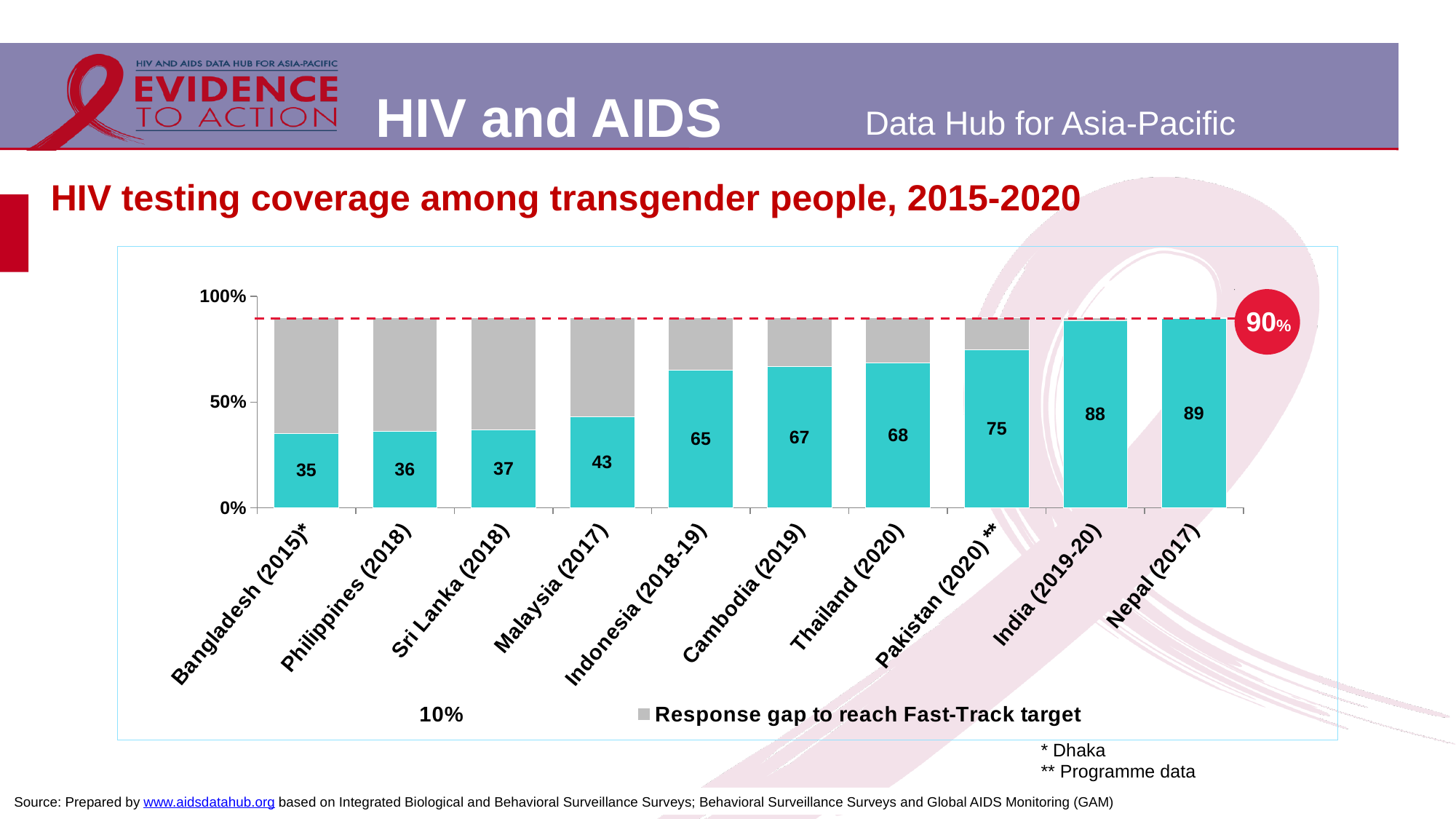
What kind of chart is used on this slide? Stacked bar chart Which country has the lowest HIV testing coverage value on the chart? Bangladesh (2015)* Do the HIV testing coverage values rise or fall from left to right across the chart? Rise What is the difference between the HIV testing coverage values for Pakistan (2020)** and Indonesia (2018-19)? 10 Is the HIV testing coverage value for Philippines (2018) greater or less than 50%? less How many countries are shown on the chart? 10 Which has a higher HIV testing coverage value, Cambodia (2019) or Sri Lanka (2018)? Cambodia (2019) What is the HIV testing coverage value shown for Thailand (2020)? 68 What is the HIV testing coverage value shown for India (2019-20)? 88 What is the HIV testing coverage value shown for Malaysia (2017)? 43 What target percentage does the red dashed line on the chart mark? 90% Which country has the highest HIV testing coverage value on the chart? Nepal (2017)